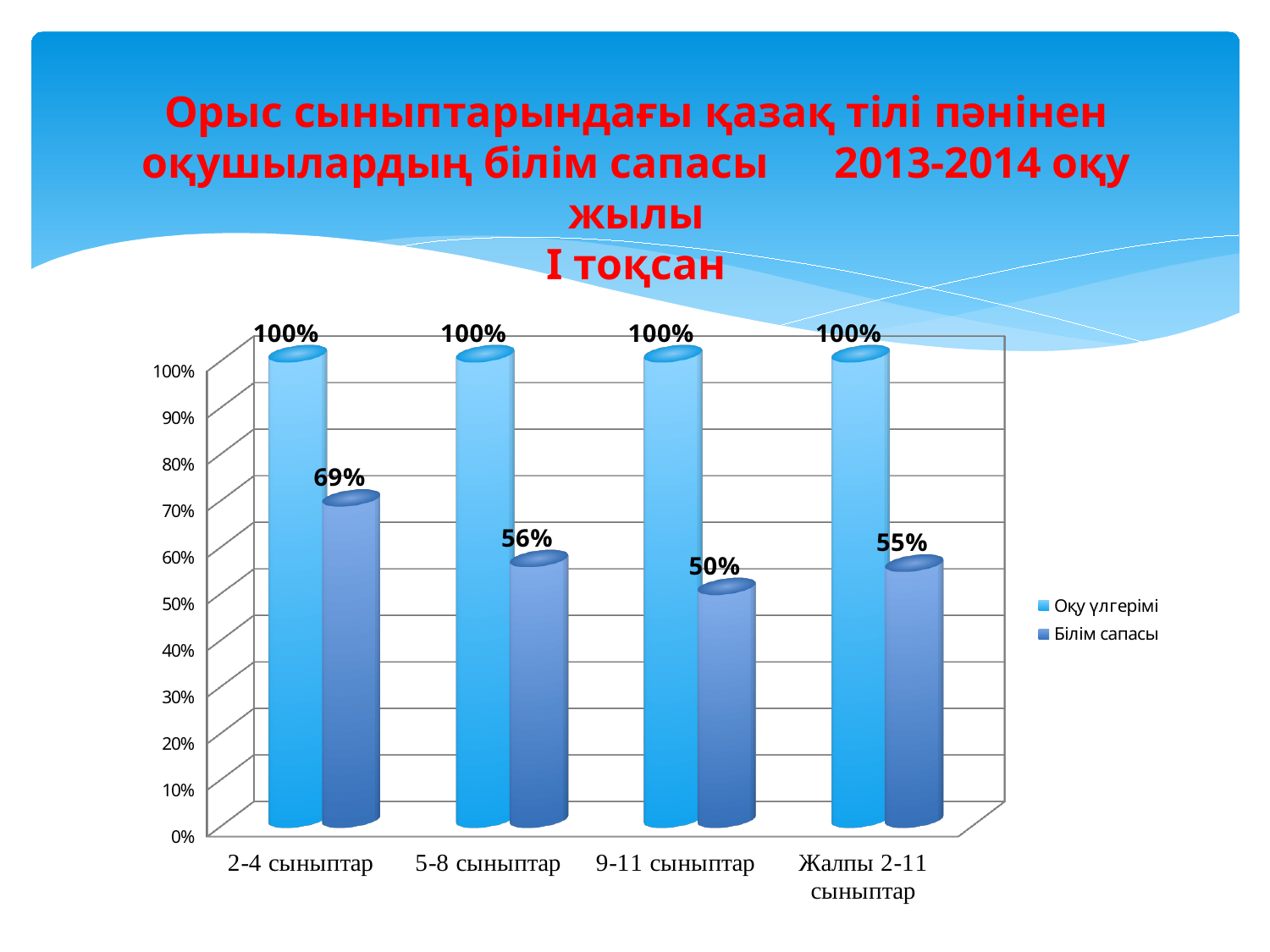
What is the difference between the Білім сапасы values for 2-4 сыныптар and 9-11 сыныптар? 19% How many categories are shown on the x axis? 4 What is the Оқу үлгерімі value for Жалпы 2-11 сыныптар? 100% How many series does the legend list? 2 What is the Білім сапасы value for 9-11 сыныптар? 50% Which is larger: the Білім сапасы value for 5-8 сыныптар or for Жалпы 2-11 сыныптар? 5-8 сыныптар What is the Білім сапасы value for 5-8 сыныптар? 56% What are the two series named in the legend? Оқу үлгерімі and Білім сапасы What is the Білім сапасы value for 2-4 сыныптар? 69% What kind of chart is shown on the slide? bar chart Which category has the highest Білім сапасы value? 2-4 сыныптар Which category has the lowest Білім сапасы value? 9-11 сыныптар